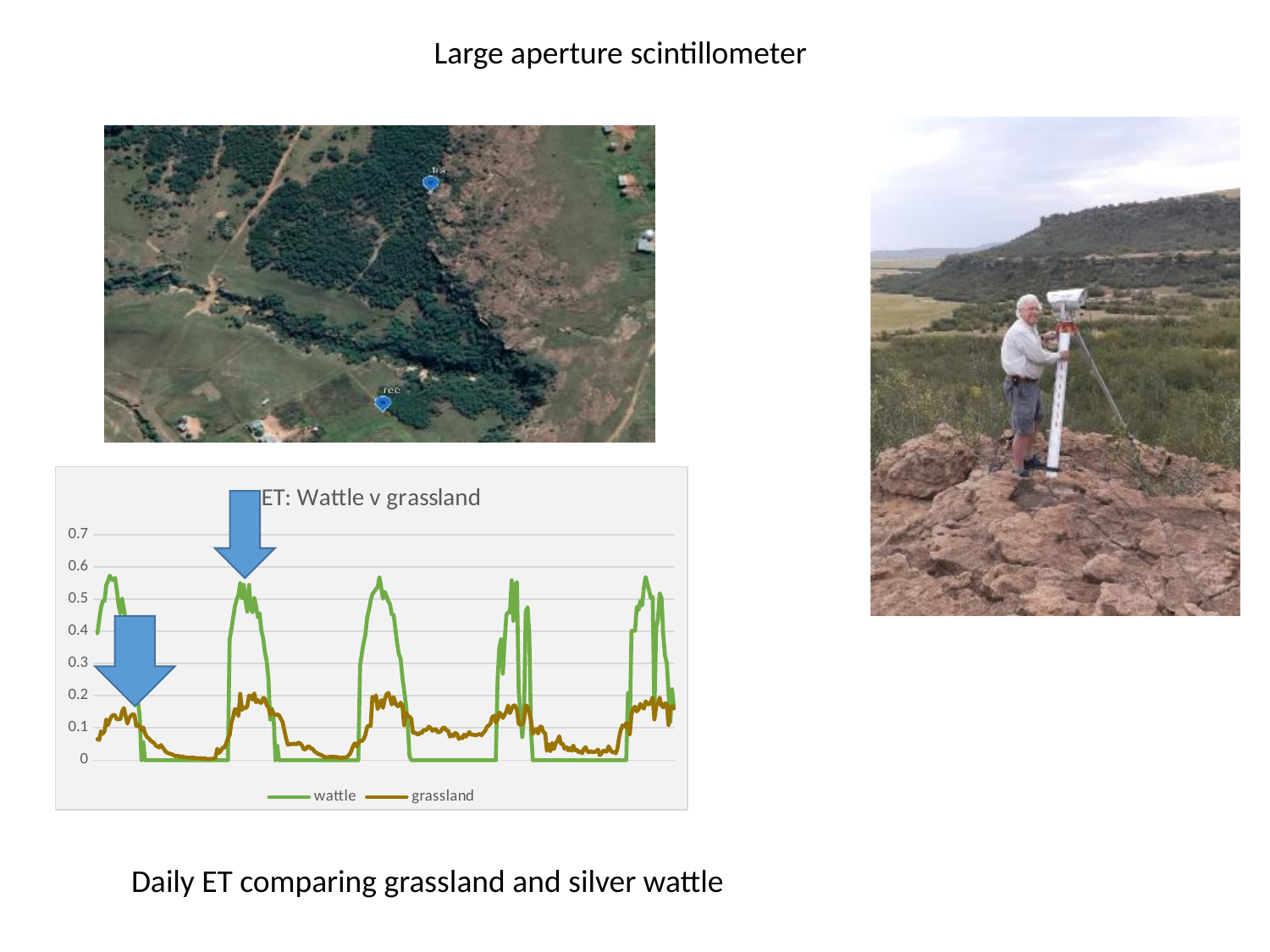
Which two series are listed in the chart's legend? wattle and grassland Is the highest value reached by the grassland series greater or less than 0.3? less What kind of chart is shown on the slide? line chart Is the highest value reached by the wattle series greater or less than 0.6? less Is the highest value reached by the wattle series greater or less than 0.5? greater What is the title of the chart? ET: Wattle v grassland How many series does the chart's legend list? 2 What is the highest tick value shown on the chart's vertical axis? 0.7 What is the lowest value the wattle series drops to on the chart? 0 Which series reaches the higher peak value, wattle or grassland? wattle